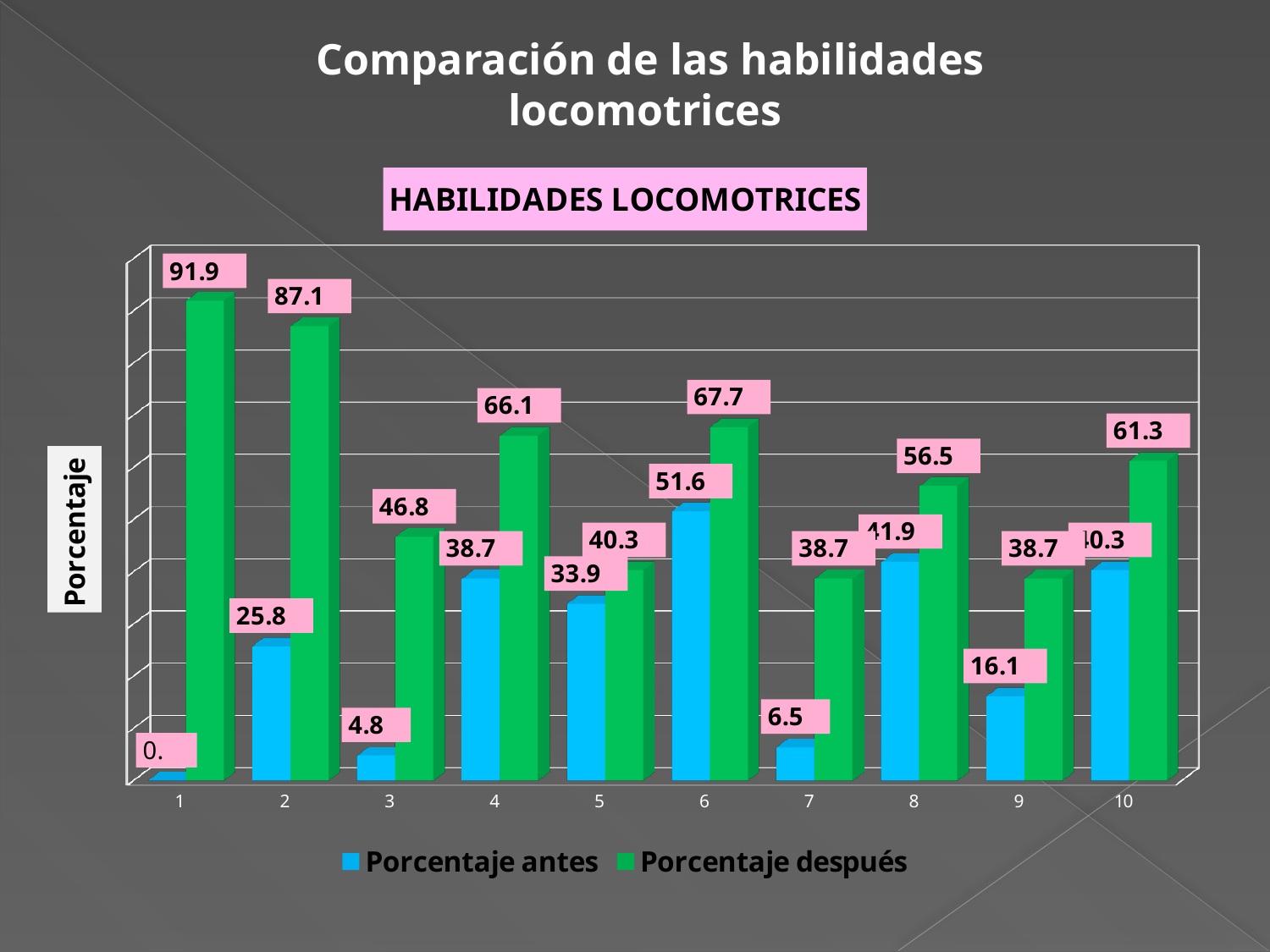
What is the difference between Porcentaje después and Porcentaje antes for category 4? 27.4 Which category has the highest Porcentaje después value? 1 What is the value of Porcentaje antes for category 2? 25.8 How many series does the legend list? 2 What are the two series named in the legend? Porcentaje antes and Porcentaje después Which category has the lowest Porcentaje después value? Categories 7 and 9 (both 38.7) What kind of chart is shown on the slide? Bar chart How many categories are shown on the x axis? 10 Which is larger: Porcentaje antes for category 6 or Porcentaje antes for category 8? Category 6 Which category has the highest Porcentaje antes value? 6 What is the value of Porcentaje después for category 7? 38.7 What is the value of Porcentaje después for category 1? 91.9